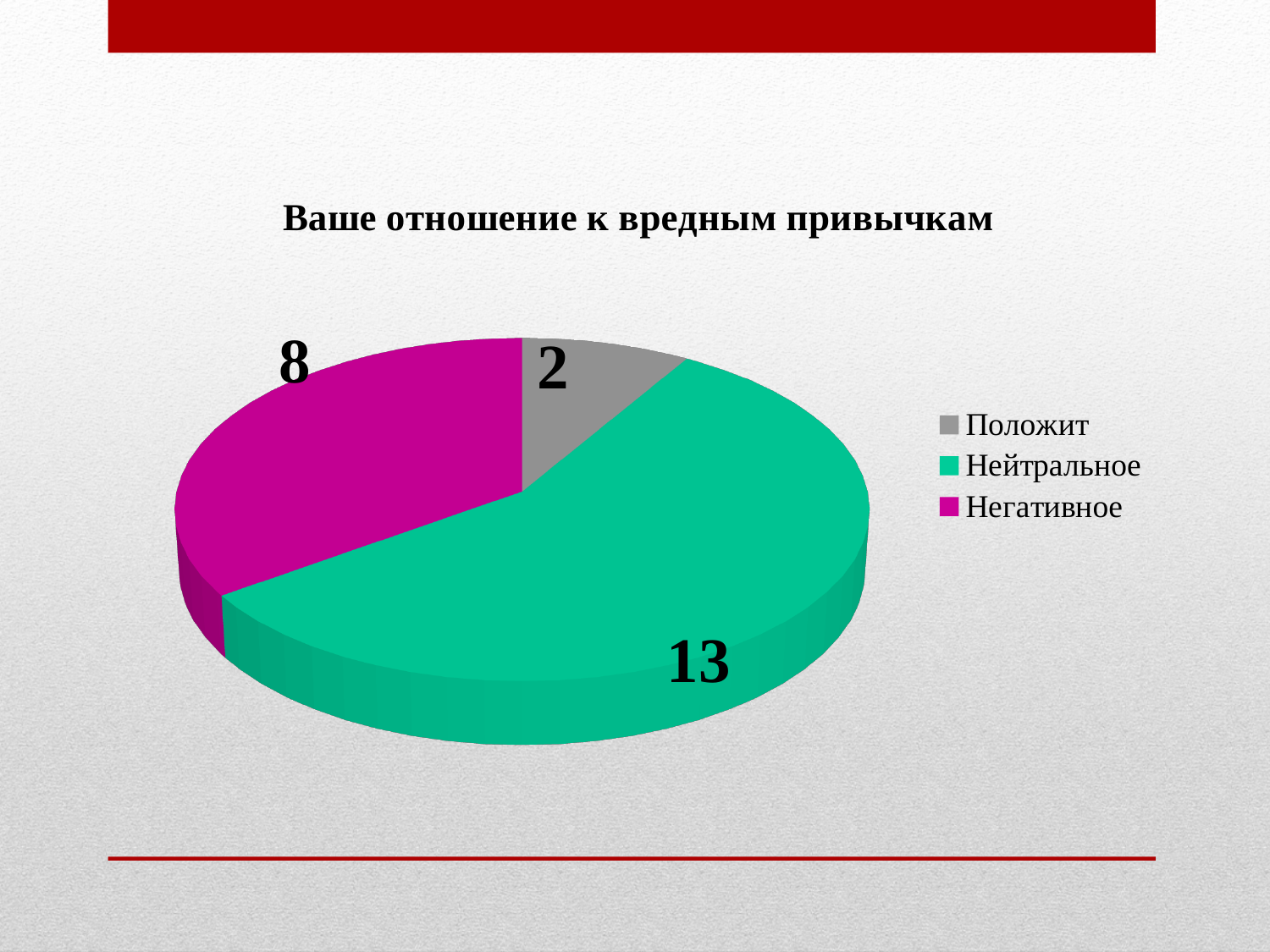
What is the total of all slices in the pie chart? 23 What is the value for Негативное? 8 Which category has the largest slice? Нейтральное What is the value for Положит? 2 What is the title of the chart? Ваше отношение к вредным привычкам Which is larger, Негативное or Положит? Негативное What colour is the Негативное slice? Magenta What is the difference between the values for Нейтральное and Негативное? 5 What kind of chart is shown on the slide? Pie chart How many categories does the pie chart show? 3 Which category has the smallest slice? Положит What is the value for Нейтральное? 13